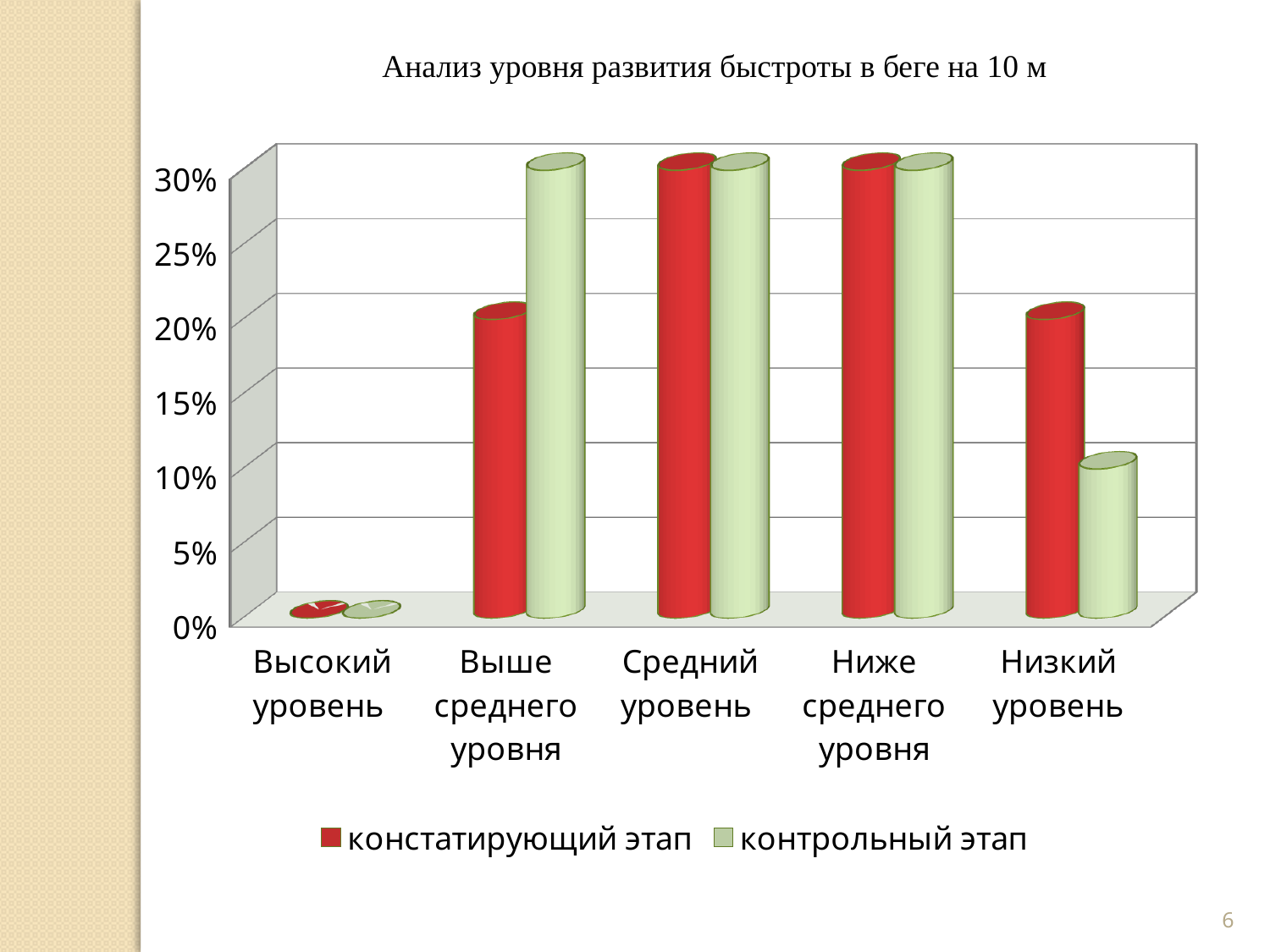
Is the value for 'Выше среднего уровня' in the 'констатирующий этап' series greater or less than 25%? less Is the value for 'Низкий уровень' in the 'констатирующий этап' series greater or less than 15%? greater Is the value for 'Низкий уровень' in the 'контрольный этап' series greater or less than 15%? less What kind of chart is shown on the slide? bar chart For 'Выше среднего уровня', which series has the larger value: 'констатирующий этап' or 'контрольный этап'? контрольный этап What is the title of the chart? Анализ уровня развития быстроты в беге на 10 м How many categories are shown on the x axis of the chart? 5 How many series does the legend list? 2 Which series is shown in red in the chart? констатирующий этап For 'Низкий уровень', which series has the larger value: 'констатирующий этап' or 'контрольный этап'? констатирующий этап Which category has the lowest value in the 'контрольный этап' series? Высокий уровень